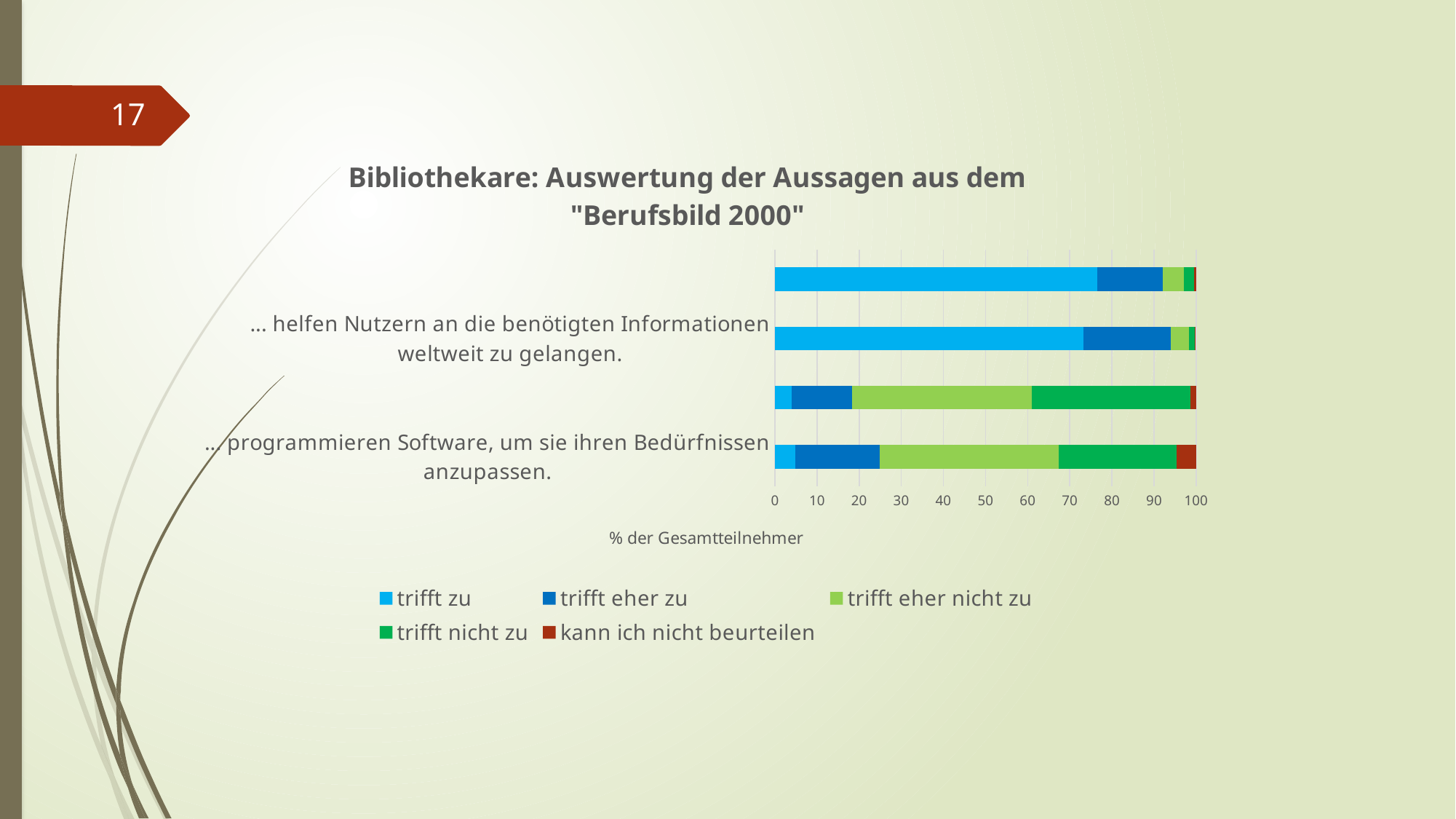
Which bar has the largest "trifft nicht zu" segment? The third bar from the top How many bars are plotted in the chart? 4 What is the title of the chart? Bibliothekare: Auswertung der Aussagen aus dem "Berufsbild 2000" What is the label of the horizontal axis? % der Gesamtteilnehmer Which is larger: the "trifft zu" segment of the top bar or the "trifft zu" segment of the bottom bar? The top bar Is the "trifft zu" segment of the bottom bar greater or less than 10? less Is the "trifft zu" segment of the top bar greater or less than 70? greater What kind of chart is shown on the slide? Stacked bar chart Is the "trifft eher nicht zu" segment of the top bar greater or less than 10? less How many series does the chart legend list? 5